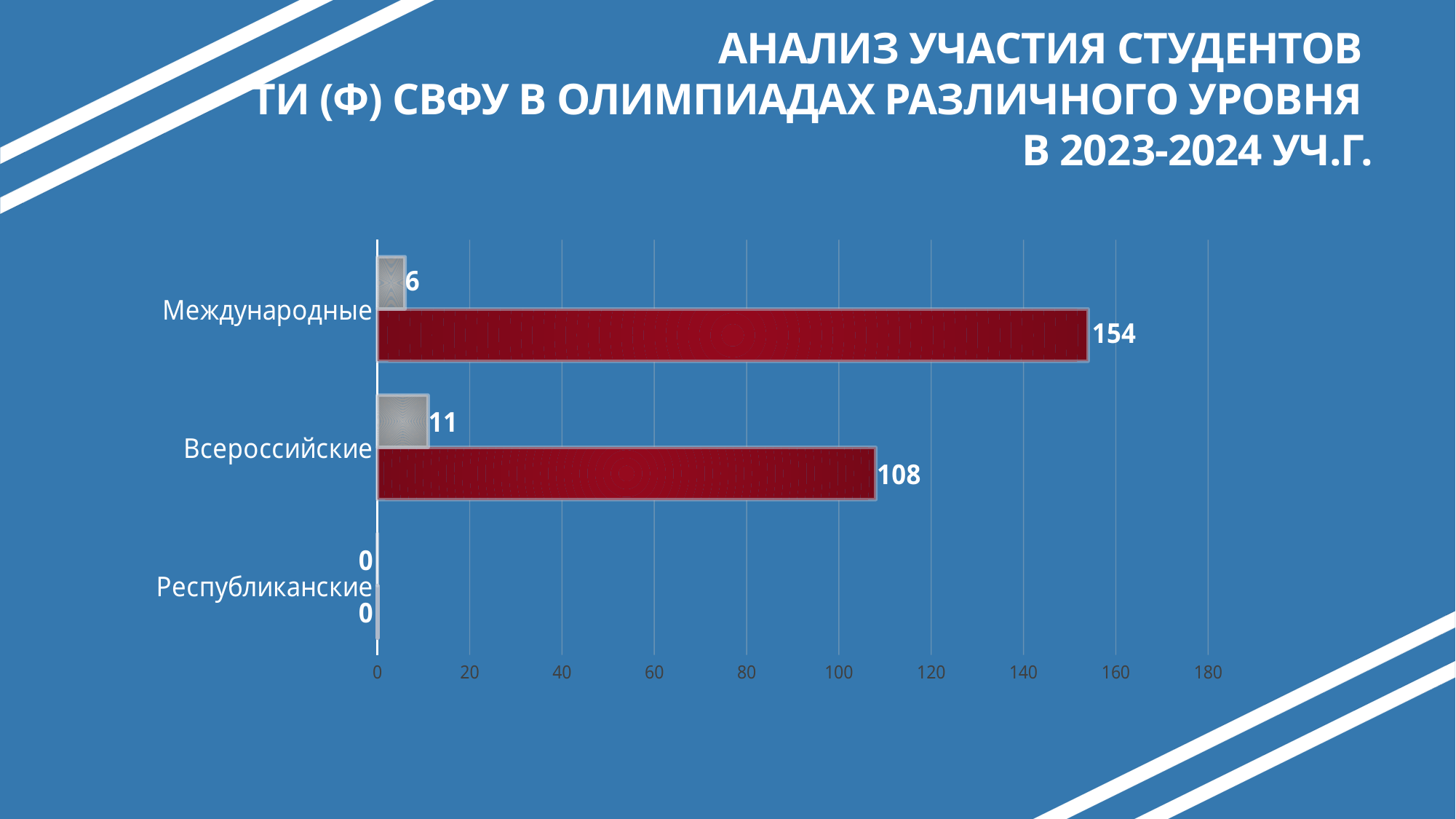
What is the value of the dark red bar for Всероссийские? 108 What type of chart is shown on the slide? Bar chart What is the value of the grey bar for Международные? 6 Which category has the highest dark red bar value? Международные What is the difference between the dark red bar values for Международные and Всероссийские? 46 What is the value of the dark red bar for Международные? 154 What is the highest tick value shown on the horizontal axis? 180 Which is larger: the grey bar for Международные or the grey bar for Всероссийские? Всероссийские How many categories are shown on the vertical axis of the chart? 3 Which category has the lowest values in the chart? Республиканские What is the value of the grey bar for Всероссийские? 11 What value is shown for Республиканские? 0